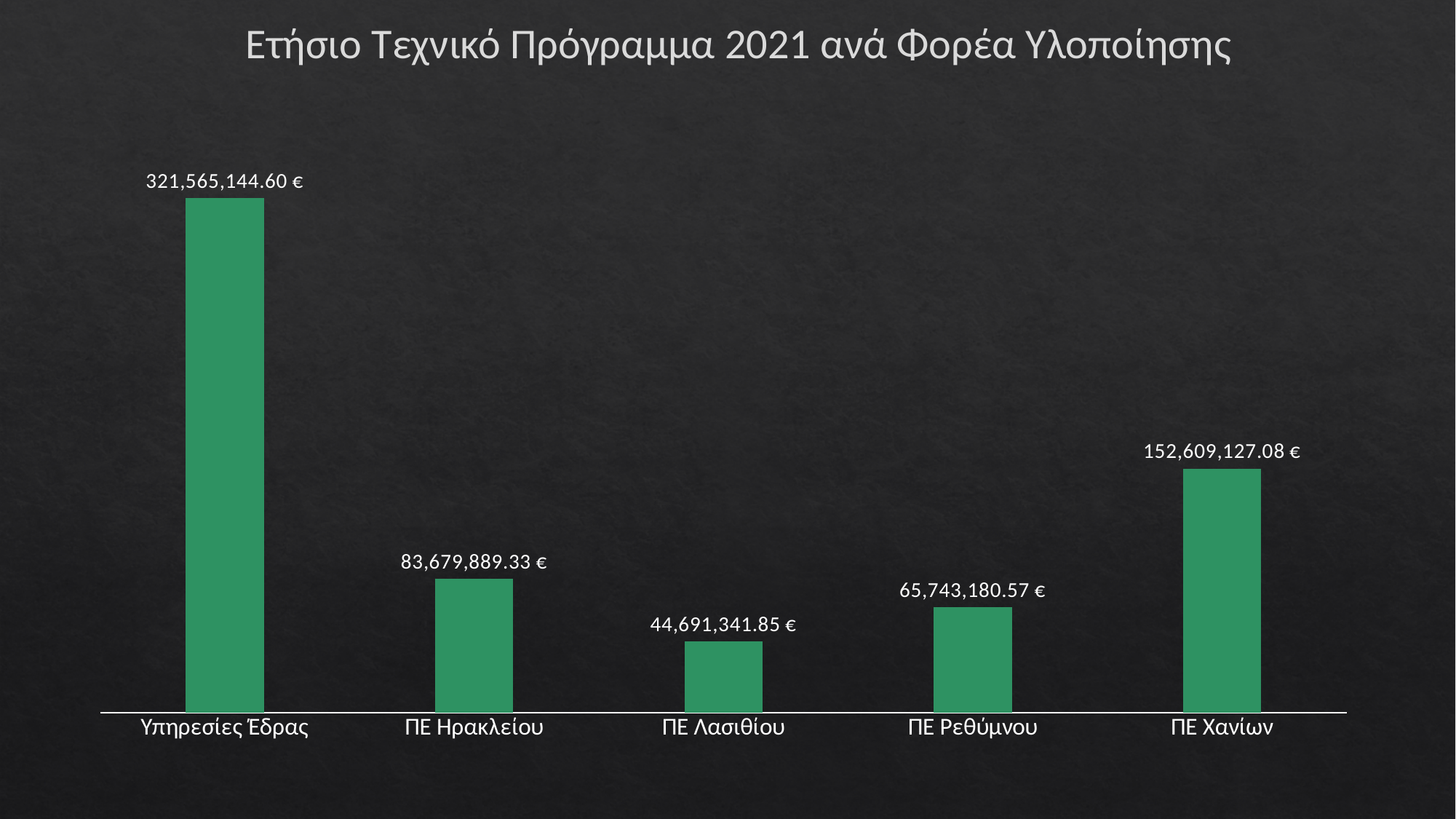
What is the value for Υπηρεσίες Έδρας? 321,565,144.60 € How many categories are shown on the chart? 5 Which is larger, the value for ΠΕ Ρεθύμνου or the value for ΠΕ Ηρακλείου? ΠΕ Ηρακλείου What is the value for ΠΕ Ηρακλείου? 83,679,889.33 € What is the value for ΠΕ Λασιθίου? 44,691,341.85 € What is the difference between the values for Υπηρεσίες Έδρας and ΠΕ Χανίων? 168,956,017.52 € What is the difference between the values for ΠΕ Ηρακλείου and ΠΕ Λασιθίου? 38,988,547.48 € What kind of chart is shown on the slide? Bar chart What is the value for ΠΕ Ρεθύμνου? 65,743,180.57 € Which category has the highest value? Υπηρεσίες Έδρας What is the value for ΠΕ Χανίων? 152,609,127.08 € Which category has the lowest value? ΠΕ Λασιθίου